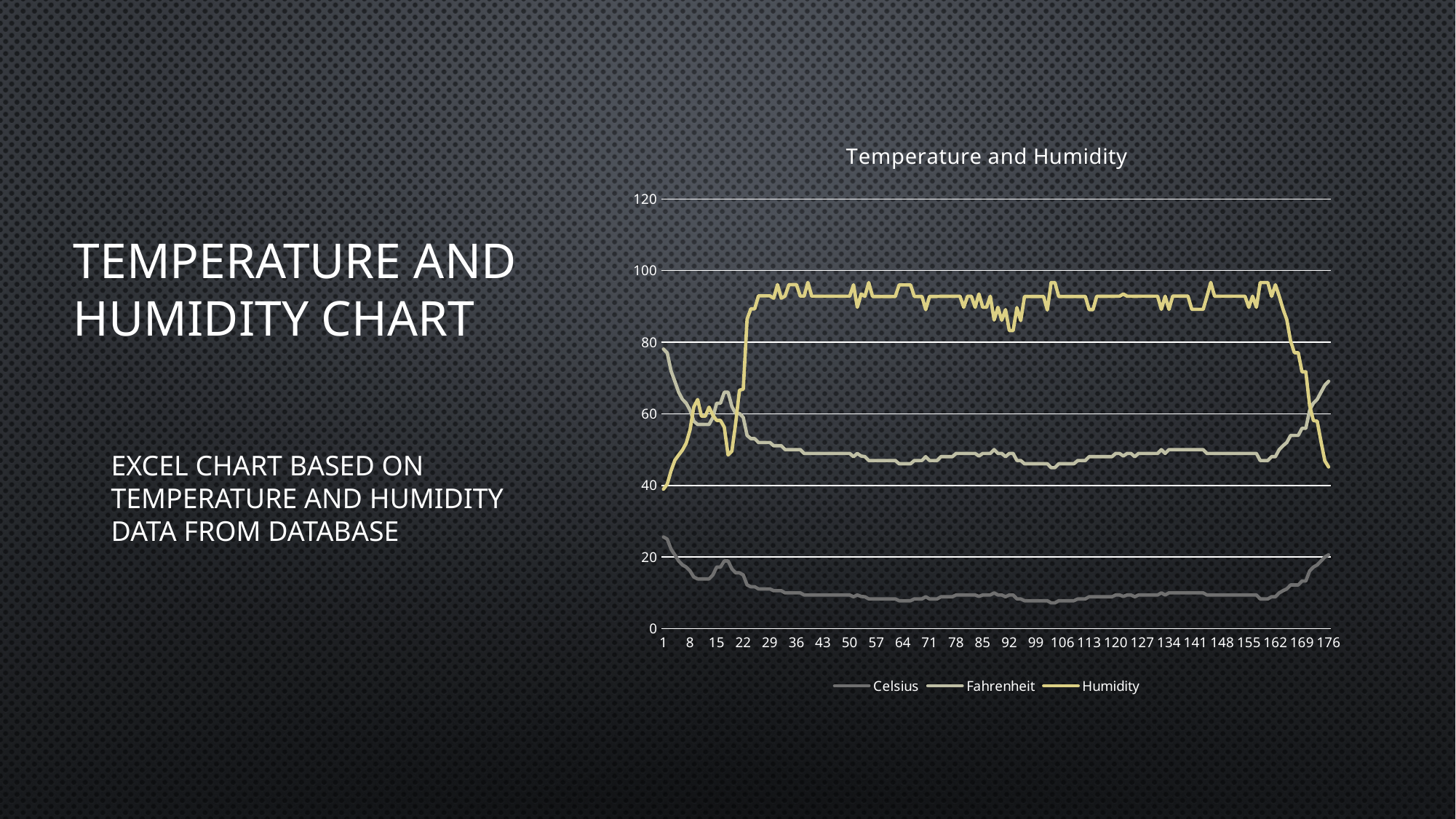
Does the Humidity line rise or fall between point 162 and point 176? fall At point 99, which series has the larger value, Fahrenheit or Celsius? Fahrenheit At point 50, which series has the larger value, Humidity or Celsius? Humidity What kind of chart is shown on the slide? line chart What is the title of the chart? Temperature and Humidity Which series are listed in the chart's legend? Celsius, Fahrenheit, Humidity Does the Celsius line rise or fall between point 1 and point 29? fall How many series does the legend of the chart list? 3 Is the Celsius value at point 64 greater or less than 20? less Is the Fahrenheit value at point 1 greater or less than 60? greater Is the Humidity value at point 50 greater or less than 80? greater